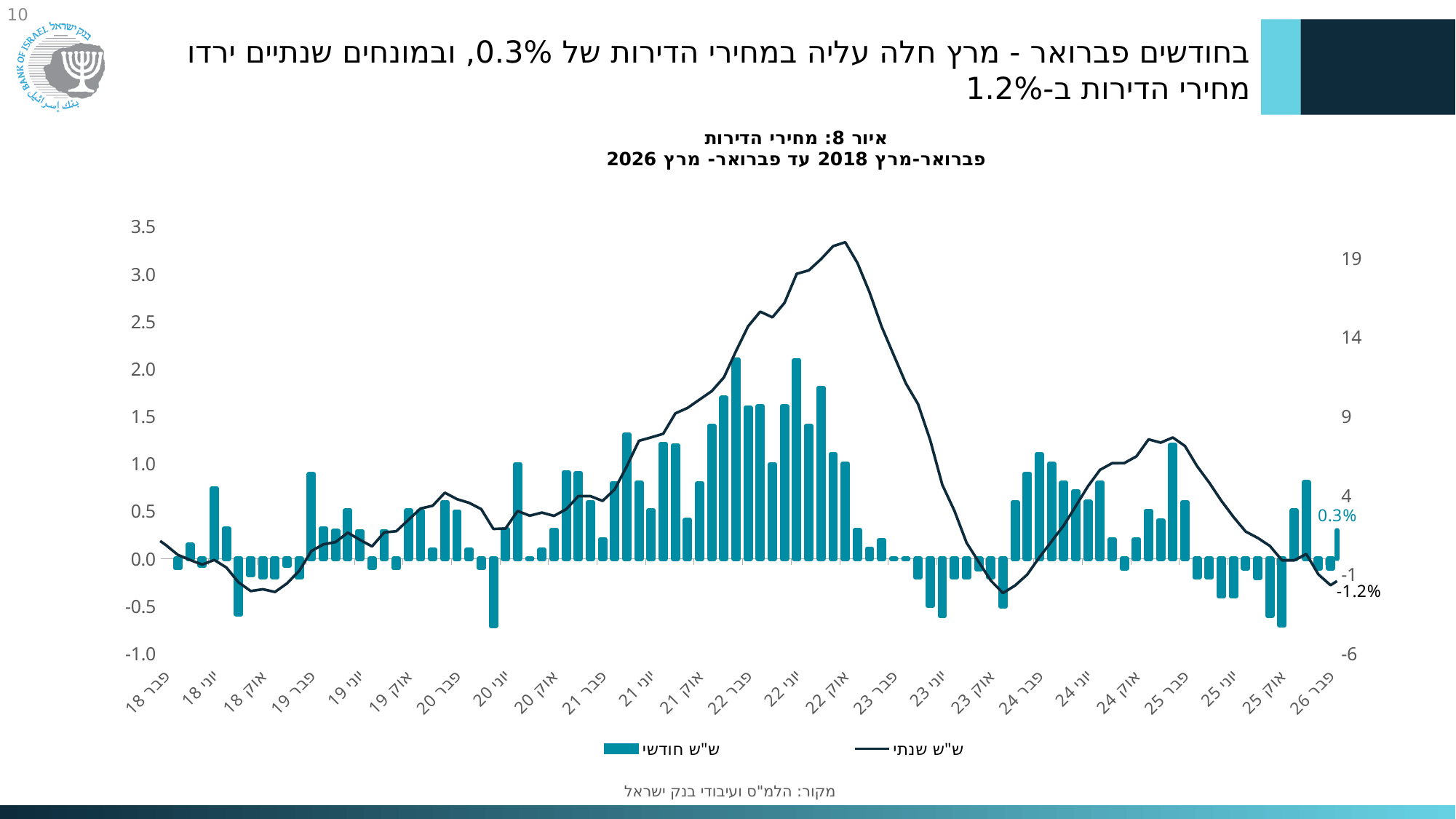
What kind of chart is this? Combined bar and line chart Does the line series rise or fall between אוק' 22 and אוק' 23? fall What is the data label shown on the last bar of the chart (Feb 26)? 0.3% Is the bar for פבר' 22 greater or less than 1.5 on the left axis? greater Which is larger, the line value at אוק' 22 or the line value at אוק' 23? אוק' 22 Is the peak of the line series (around אוק' 22) greater or less than 14 on the right axis? greater Is the bar for יוני 20 greater or less than -0.5 on the left axis? greater Which series is drawn as bars according to the legend? ש"ש חודשי How many series does the legend list? 2 What is the data label shown at the end of the line series (Feb 26)? -1.2% What is the title of the chart? איור 8: מחירי הדירות פברואר-מרץ 2018 עד פברואר- מרץ 2026 Which is larger, the bar for פבר' 22 or the bar for פבר' 23? פבר' 22